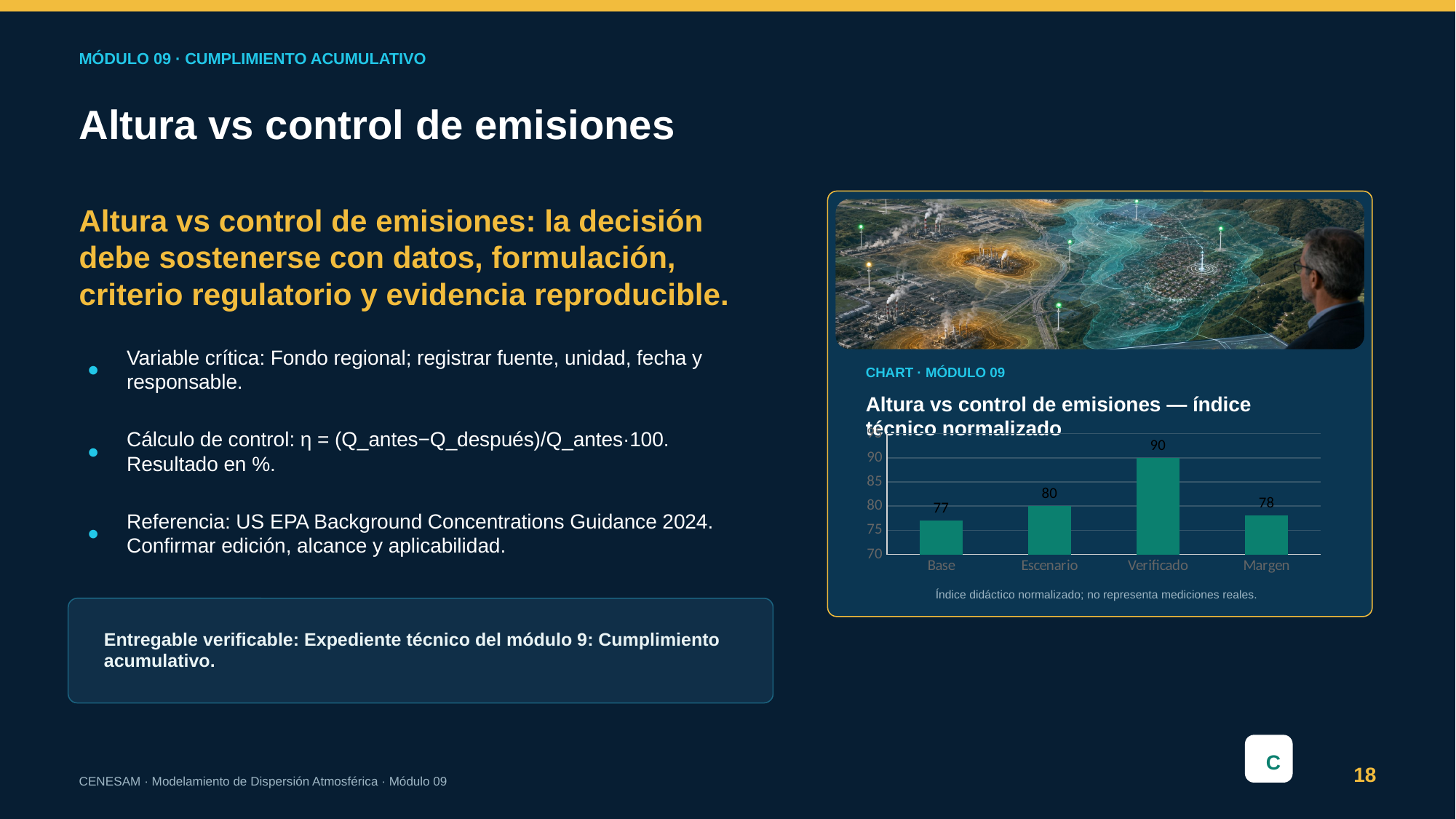
How many categories are shown on the x axis? 4 What kind of chart is shown on the slide? bar chart What is the value for Escenario? 80 Is the value for Verificado greater or less than 85? greater What is the value for Base? 77 What is the value for Margen? 78 What is the title of the chart? Altura vs control de emisiones — índice técnico normalizado Which is larger, the value for Escenario or the value for Margen? Escenario Which category has the highest value? Verificado What is the difference between the values for Verificado and Escenario? 10 What is the value for Verificado? 90 Which category has the lowest value? Base